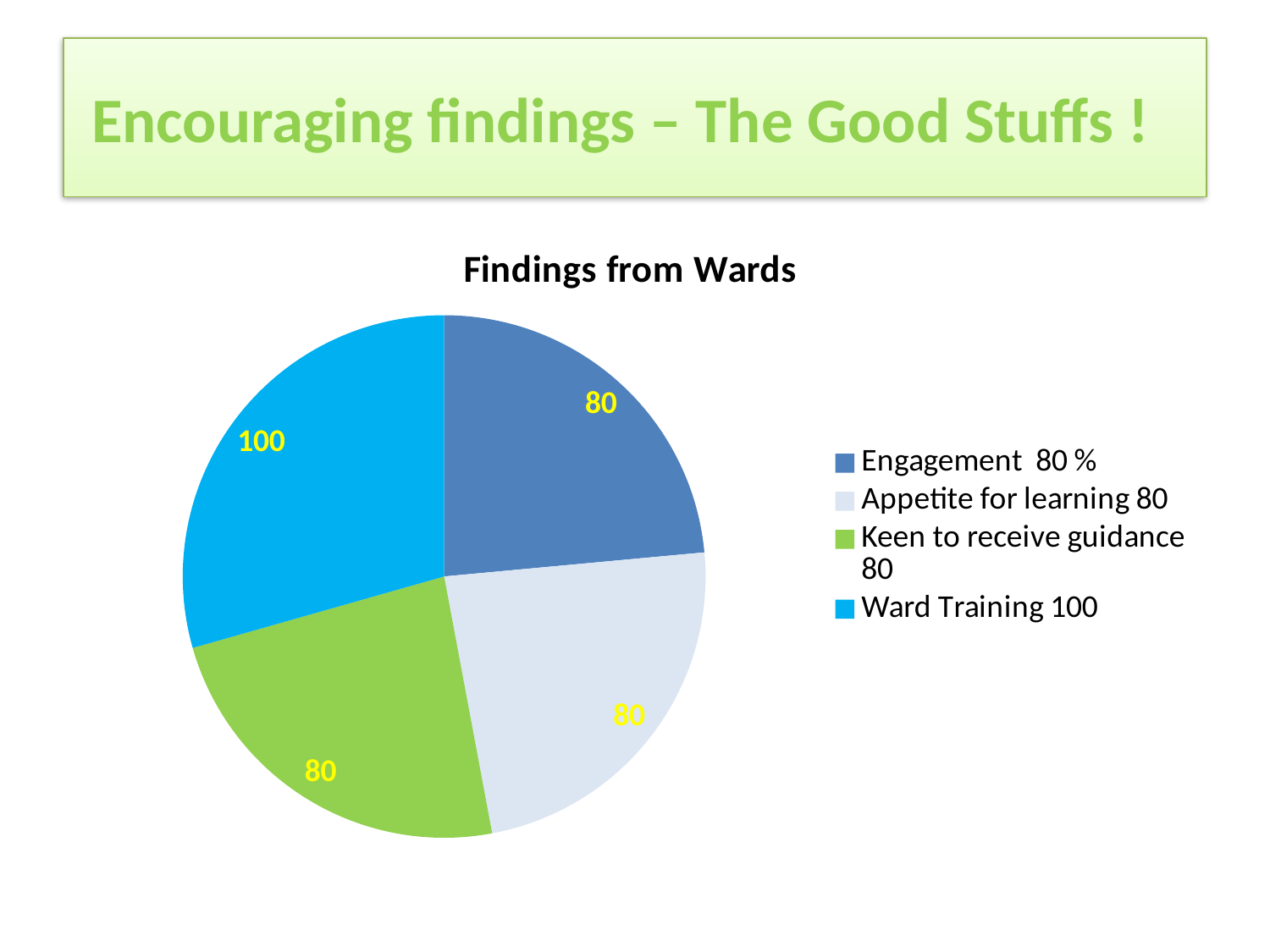
Which category has the largest slice in the pie chart? Ward Training What is the value shown for the Engagement slice? 80 What is the value shown for the Keen to receive guidance slice? 80 Which is larger, the Ward Training slice or the Keen to receive guidance slice? Ward Training How many slices does the pie chart have? 4 What is the value shown for the Ward Training slice? 100 How many entries does the legend list? 4 Which category is shown in green in the pie chart? Keen to receive guidance What type of chart is shown on the slide? Pie chart What is the difference between the Ward Training value and the Engagement value? 20 What is the value shown for the Appetite for learning slice? 80 What is the title of the chart? Findings from Wards